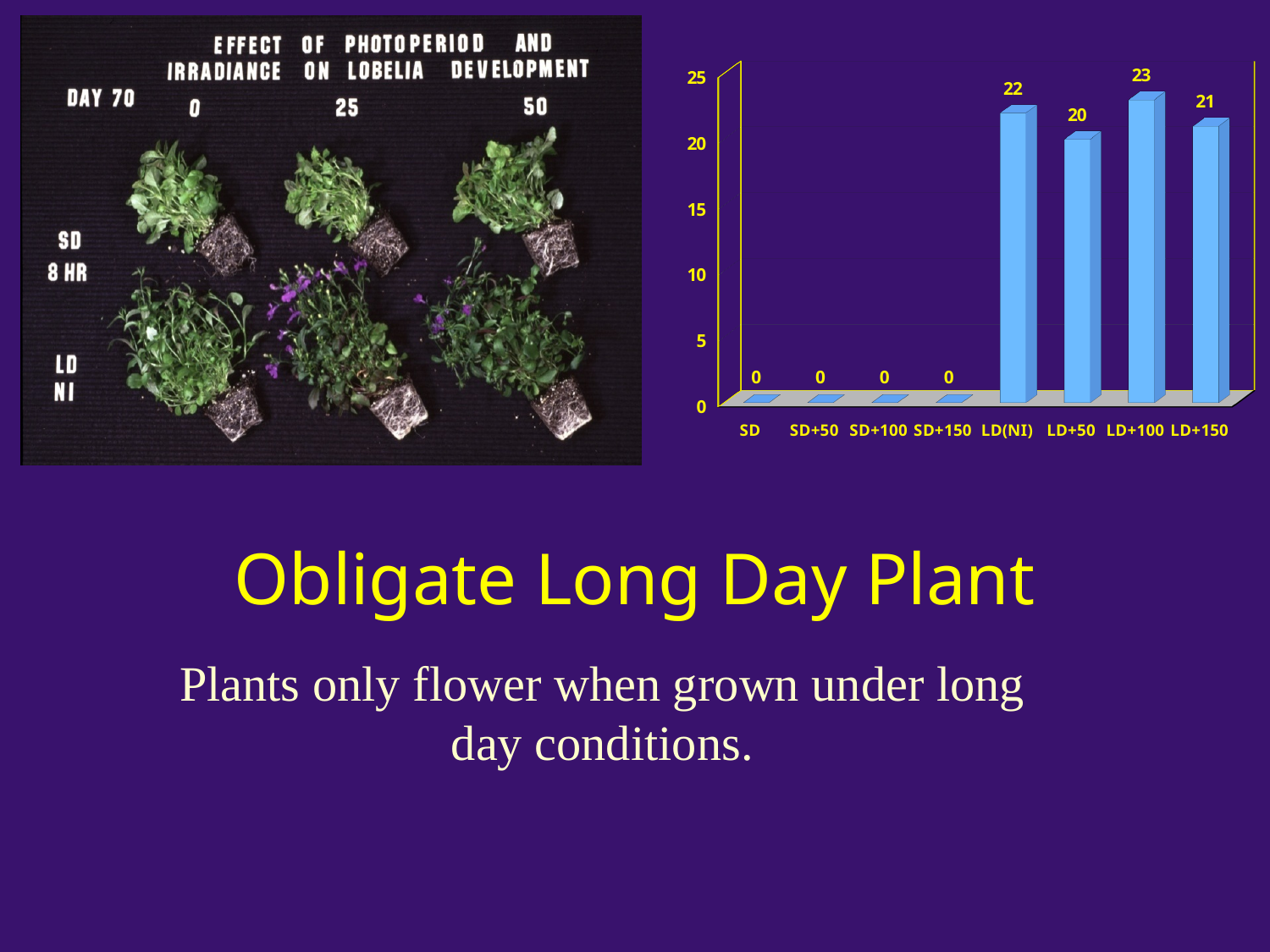
What kind of chart is shown? bar chart What is the value for SD+100? 0 What is the difference between the values for LD+100 and LD+50? 3 Which is larger, the value for LD(NI) or the value for LD+150? LD(NI) How many categories are shown on the x axis? 8 What is the value for LD(NI)? 22 Is the value for LD+50 greater or less than 15? greater What is the value for LD+150? 21 Which category has the highest value? LD+100 What is the value for LD+50? 20 How many categories have a value of 0? 4 What is the value for LD+100? 23